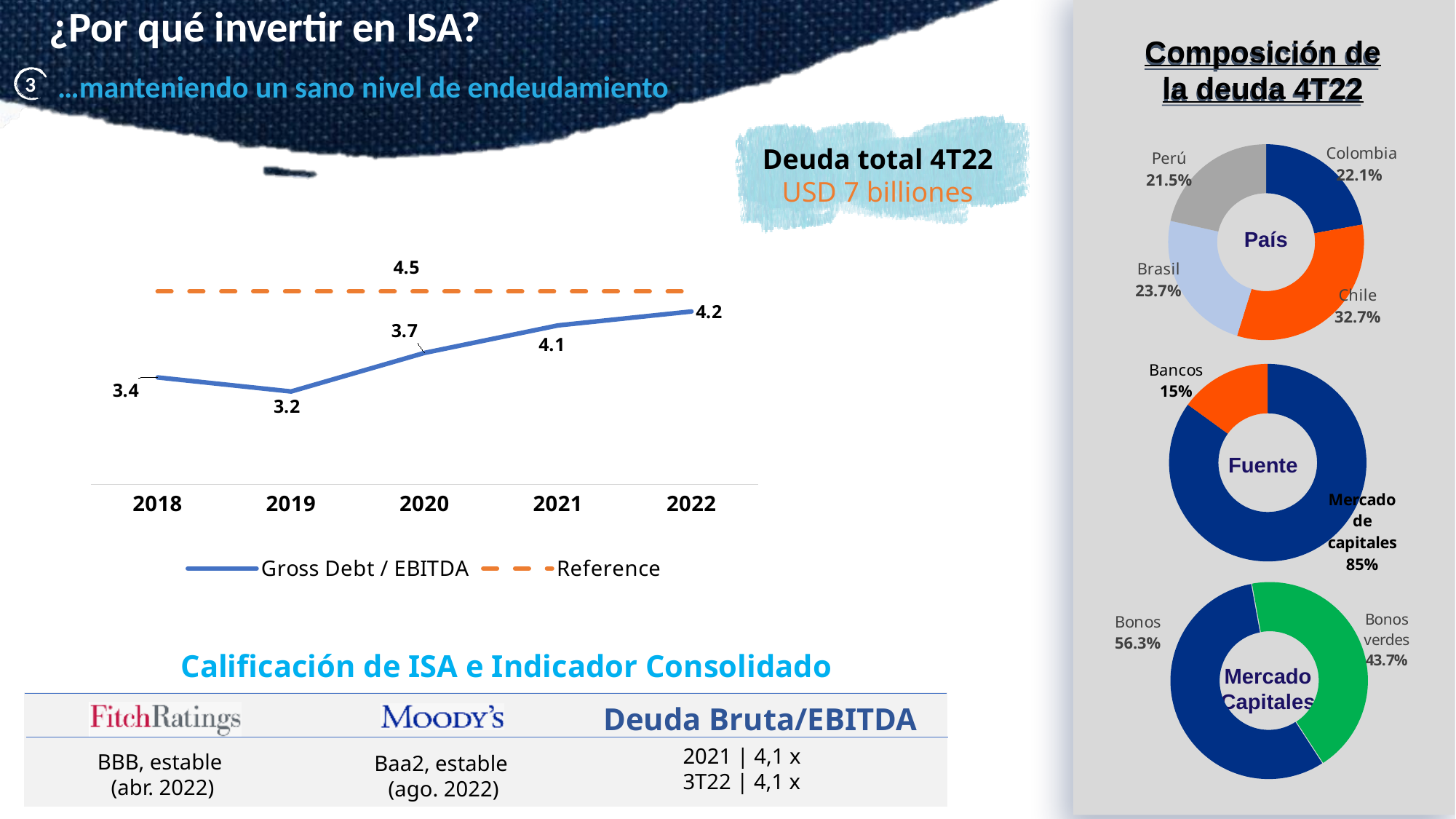
In the País donut chart, which country has the smallest share? Perú In the País donut chart, what share does Chile have? 32.7% In the line chart, what is the Gross Debt / EBITDA value for 2019? 3.2 In the line chart, what is the difference between the Reference value and the Gross Debt / EBITDA value for 2022? 0.3 In the line chart, how many years are shown on the x axis? 5 In the line chart, which year has the highest Gross Debt / EBITDA value? 2022 In the Mercado Capitales donut chart, which is larger, Bonos or Bonos verdes? Bonos In the line chart, does the Gross Debt / EBITDA value rise or fall from 2019 to 2022? rise In the line chart, what is the Gross Debt / EBITDA value for 2022? 4.2 In the Fuente donut chart, what share does Bancos have? 15% In the line chart, which year has the lowest Gross Debt / EBITDA value? 2019 In the line chart, how many series does the legend list? 2